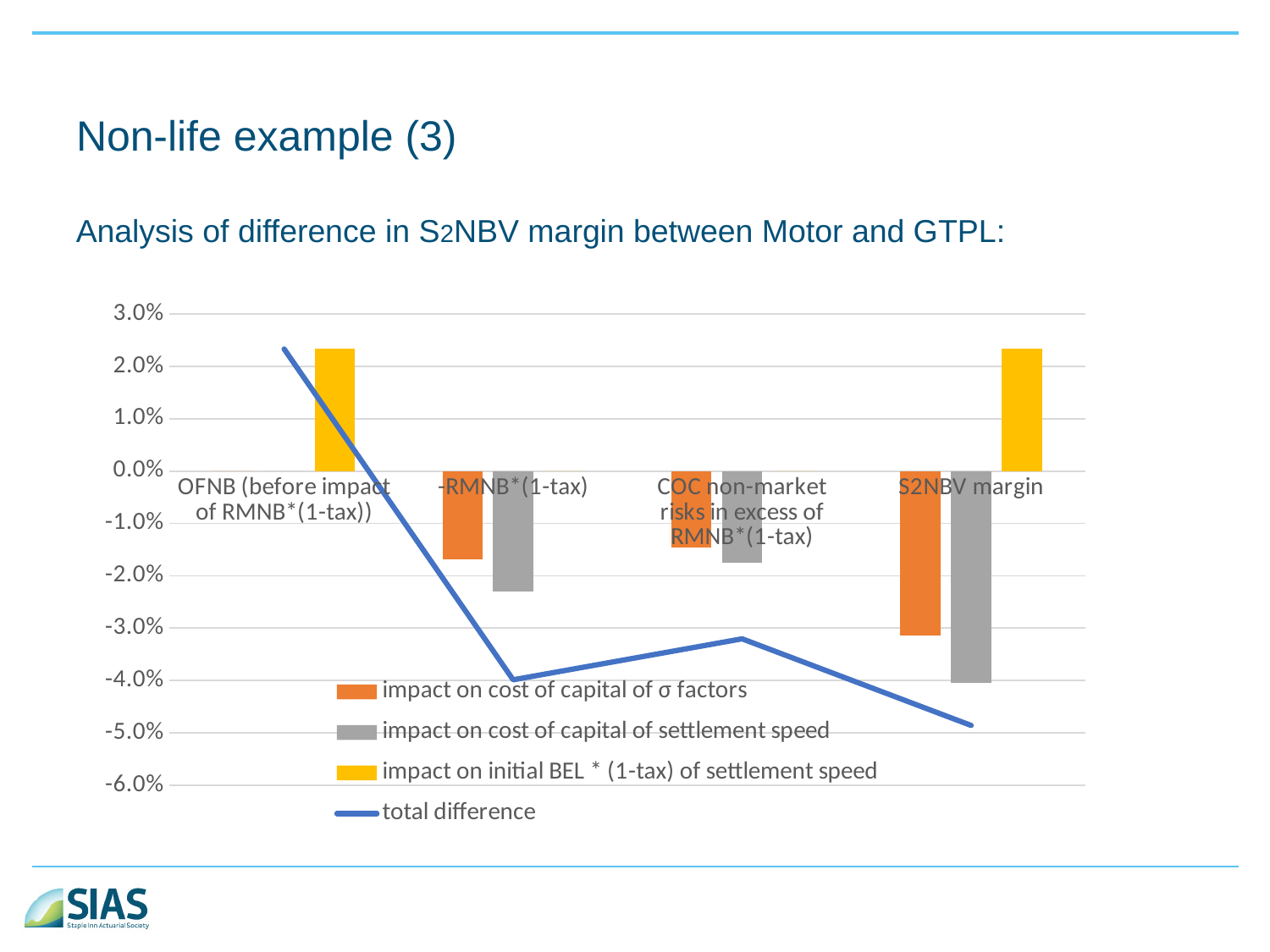
How many categories are shown along the x axis of the chart? 4 Which colour represents 'impact on initial BEL * (1-tax) of settlement speed'? Yellow For '-RMNB*(1-tax)', which bar extends further below zero: 'impact on cost of capital of σ factors' or 'impact on cost of capital of settlement speed'? impact on cost of capital of settlement speed Is the 'impact on cost of capital of σ factors' value for 'S2NBV margin' greater or less than -3.0%? less Which series is drawn as a line rather than bars? total difference Is the 'impact on cost of capital of settlement speed' value for '-RMNB*(1-tax)' greater or less than -2.0%? less Is the 'total difference' value for 'S2NBV margin' greater or less than -4.0%? less What kind of chart is shown on the slide? Combined bar and line chart How many series does the chart legend list? 4 At which category is the 'total difference' line at its lowest? S2NBV margin At which category is the 'total difference' line at its highest? OFNB (before impact of RMNB*(1-tax))